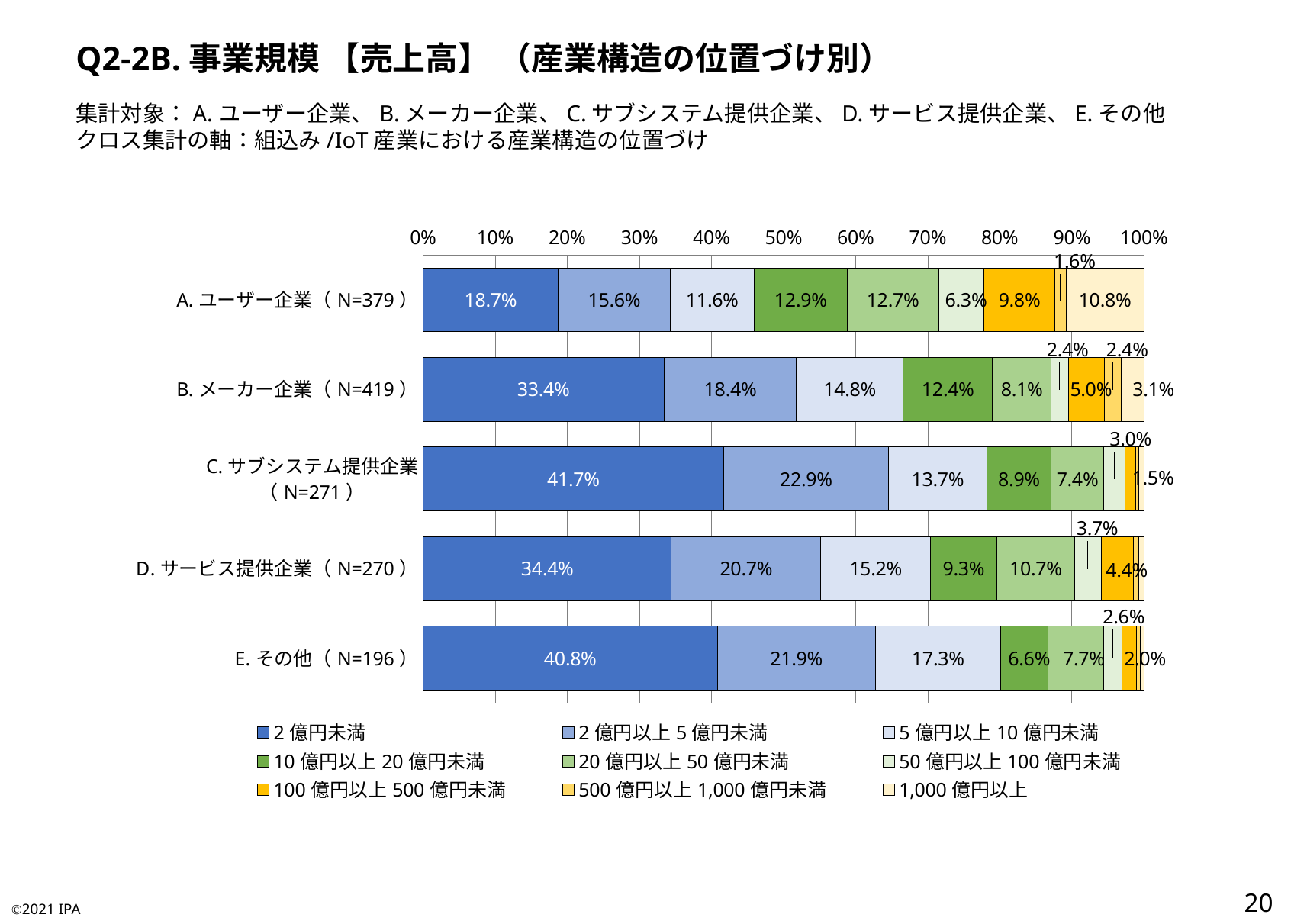
Which category has the lowest value for 2 億円未満? A. ユーザー企業 What kind of chart is shown on the slide? Stacked horizontal bar chart What is the value for 5 億円以上 10 億円未満 for E. その他? 17.3% What is the difference between the 2 億円未満 values for C. サブシステム提供企業 and A. ユーザー企業? 23.0 percentage points What is the value for 100 億円以上 500 億円未満 for B. メーカー企業? 5.0% What is the value for 2 億円未満 for A. ユーザー企業? 18.7% Which category has the highest value for 1,000 億円以上? A. ユーザー企業 Which has the larger value for 2 億円以上 5 億円未満, B. メーカー企業 or D. サービス提供企業? D. サービス提供企業 What is the value for 2 億円未満 for C. サブシステム提供企業? 41.7% How many series does the legend list? 9 Which category has the highest value for 2 億円未満? C. サブシステム提供企業 How many categories are shown on the chart? 5